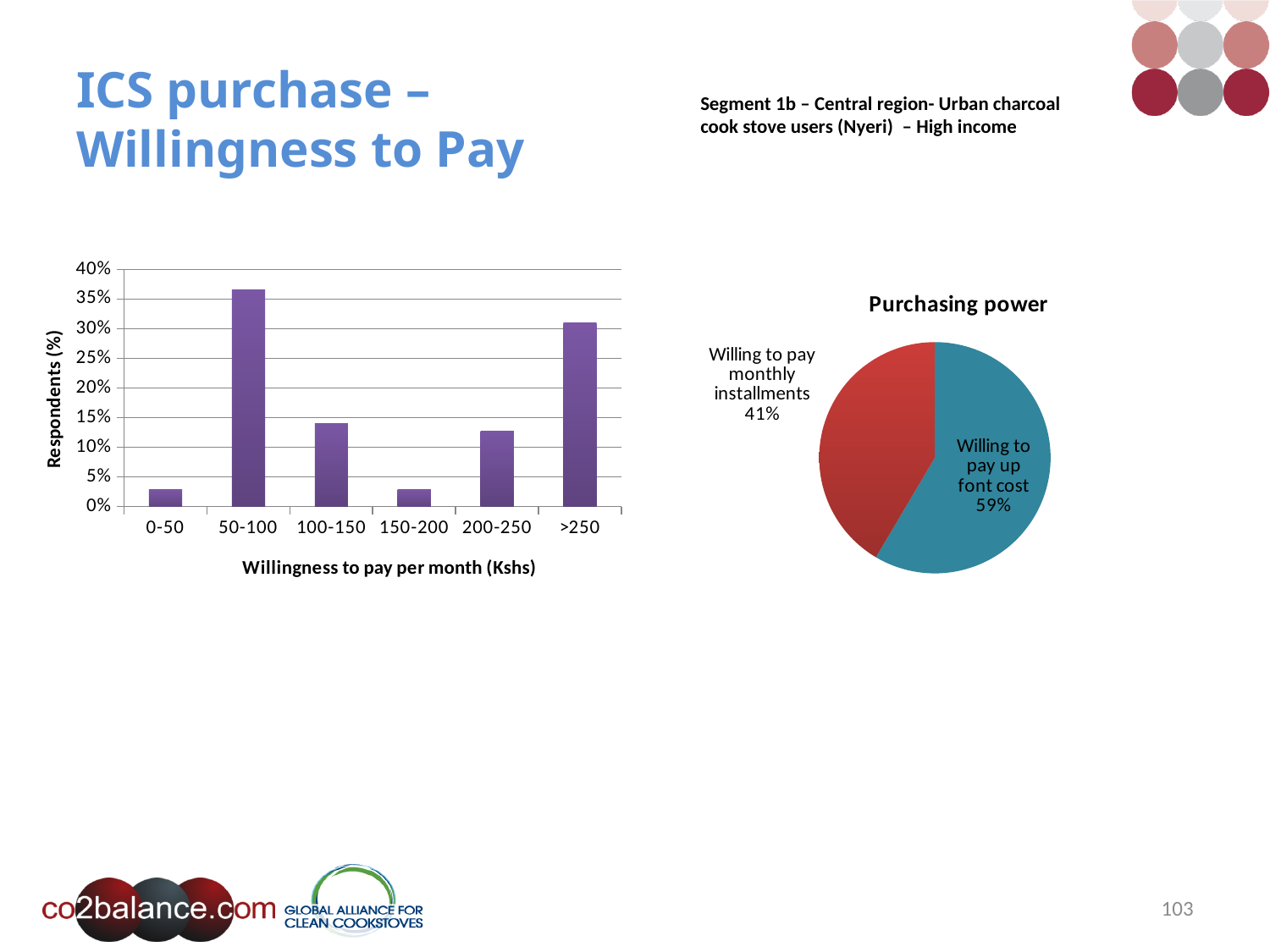
In the bar chart on the left, which has a larger share of respondents, 100-150 or 200-250? 100-150 In the bar chart on the left, is the value for 50-100 greater or less than 35%? greater In the bar chart on the left, which willingness-to-pay category has the highest share of respondents? 50-100 In the Purchasing power pie chart, what share of respondents are willing to pay monthly installments? 41% In the bar chart on the left, is the value for 0-50 greater or less than 5%? less In the bar chart on the left, which has a larger share of respondents, >250 or 50-100? 50-100 In the Purchasing power pie chart, what is the difference in percentage points between the two slices? 18 percentage points In the Purchasing power pie chart, what share of respondents are willing to pay up front cost? 59% How many willingness-to-pay categories are shown on the x axis of the bar chart on the left? 6 What type of chart is the chart on the left of the slide? bar chart